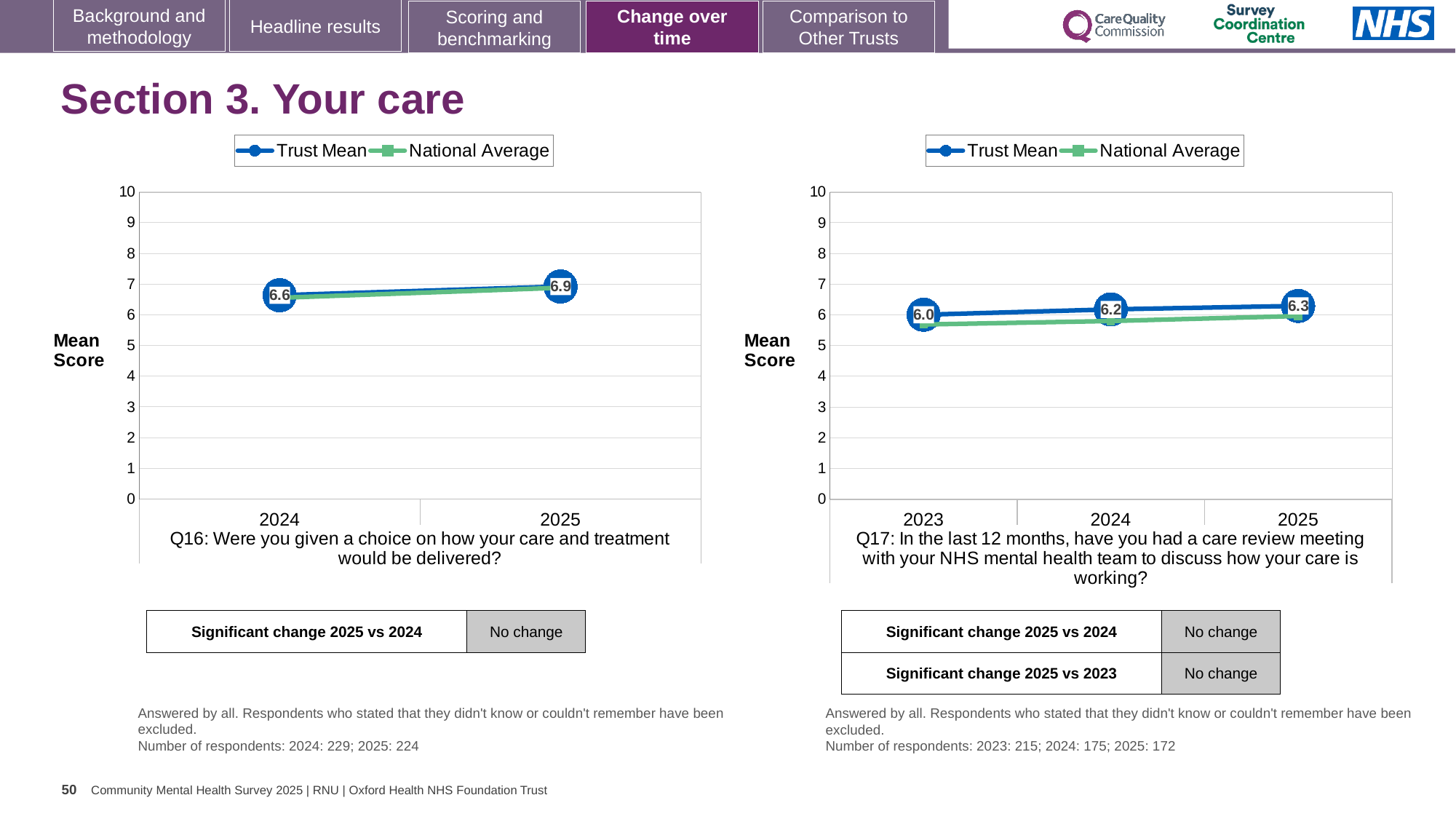
On the Q17 chart, how many years are plotted on the x axis? 3 On the Q17 chart, what is the Trust Mean for 2025? 6.3 On the Q17 chart, is the National Average for 2025 greater or less than 7? less On the Q16 chart, what is the Trust Mean for 2024? 6.6 On the Q16 chart, does the Trust Mean rise or fall from 2024 to 2025? rise On the Q17 chart, what is the difference between the Trust Mean in 2025 and in 2023? 0.3 How many series does the legend of the Q16 chart list? 2 On the Q17 chart, which year has the lowest Trust Mean? 2023 On the Q16 chart, by how much did the Trust Mean change from 2024 to 2025? 0.3 On the Q17 chart, what is the Trust Mean for 2023? 6.0 What type of chart is the Q17 chart? line chart On the Q16 chart, what is the Trust Mean for 2025? 6.9